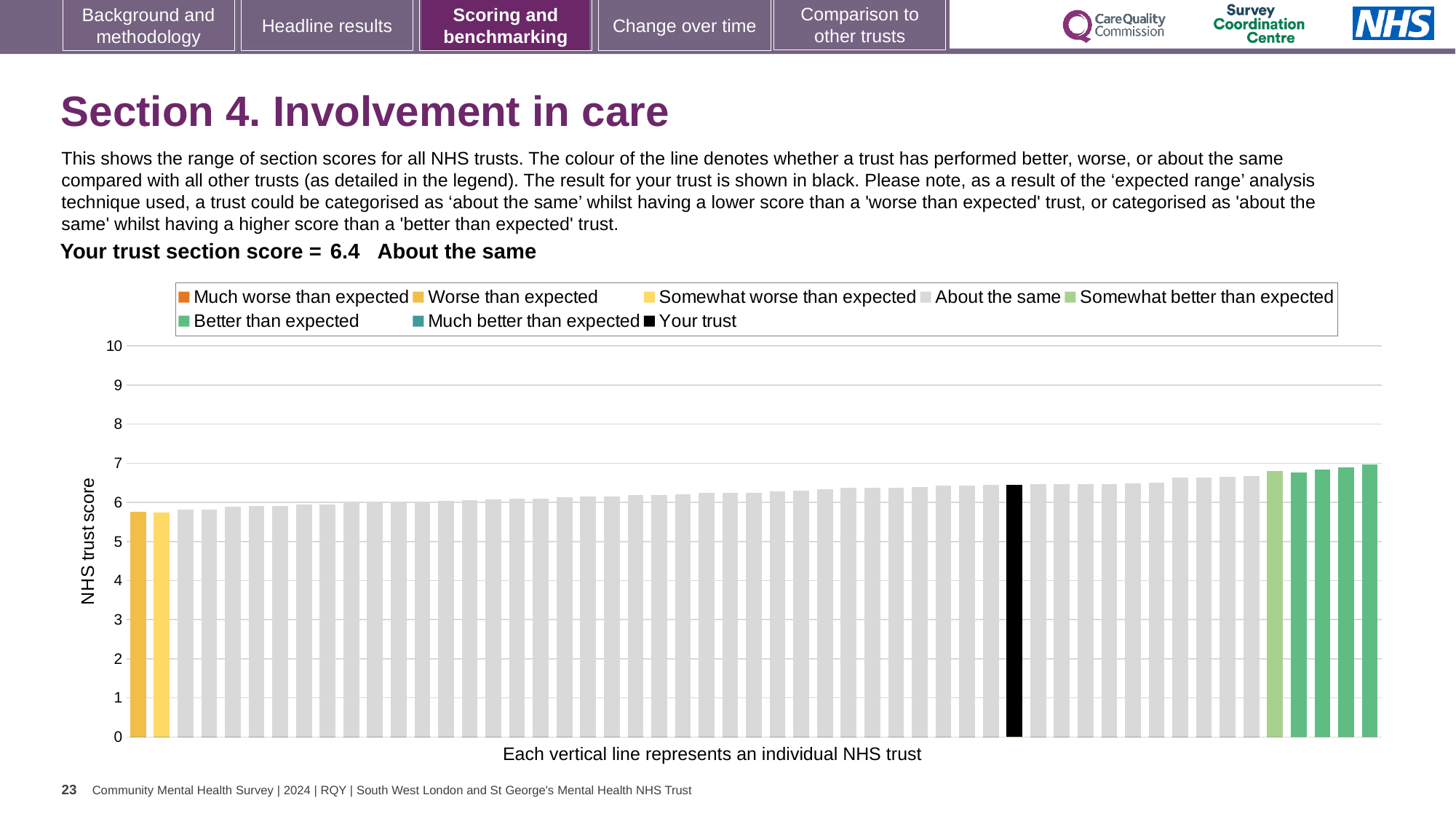
How many entries does the chart legend list? 8 Which performance category is your trust placed in for this section? About the same Do the bar values rise or fall from left to right along the x axis? rise Is the value of the rightmost (highest) bar greater or less than 6? greater What is the section score for your trust shown on the slide? 6.4 Is the value of the leftmost bar greater or less than 6? less Is the value of the black 'Your trust' bar greater or less than 7? less Which of the two is larger: the black 'Your trust' bar or the leftmost bar? the black 'Your trust' bar What colour is the bar representing your trust? black What kind of chart is shown on the slide? bar chart